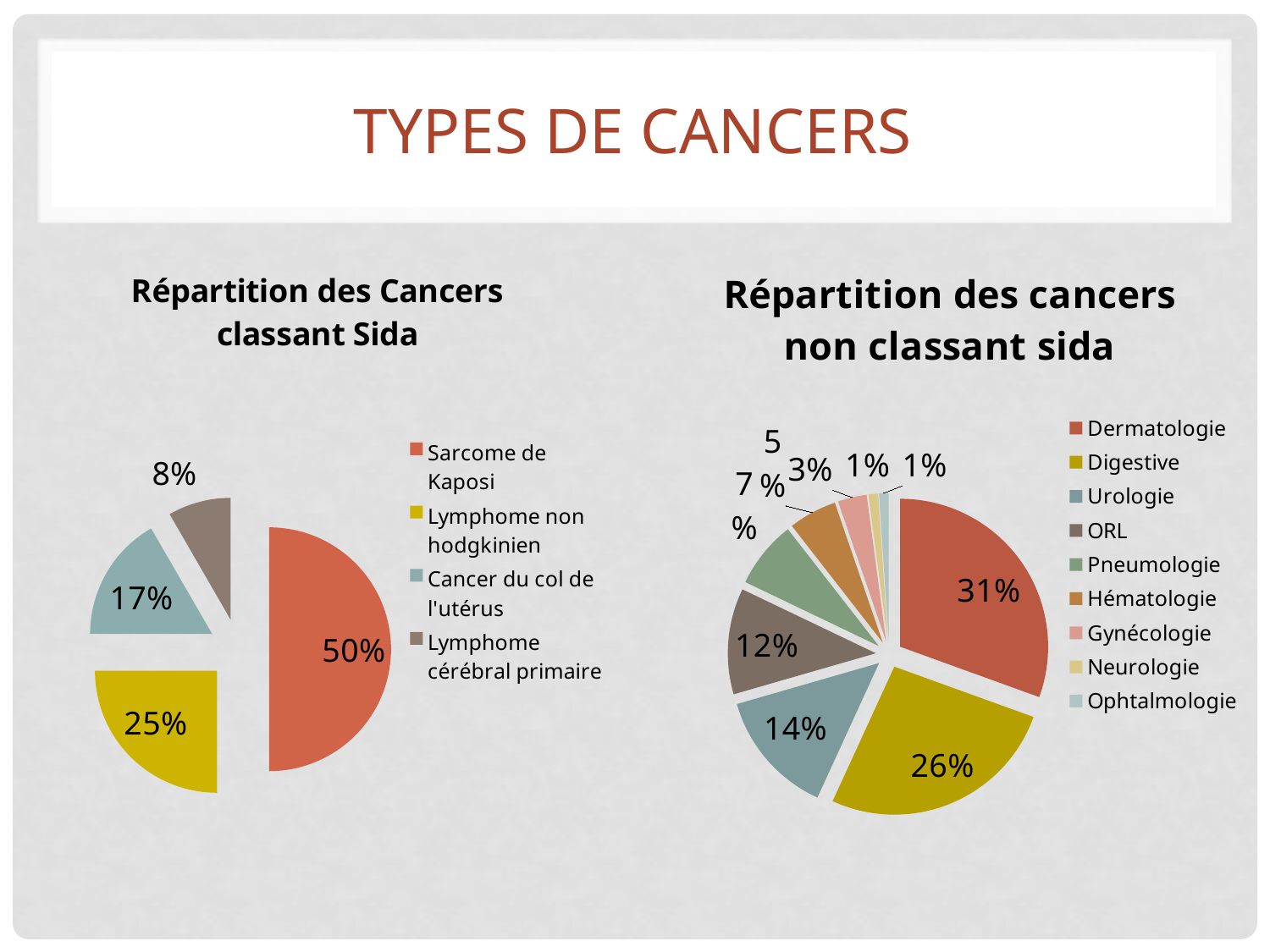
In the "Répartition des Cancers classant Sida" chart, what is the difference between the shares of Sarcome de Kaposi and Lymphome non hodgkinien? 25% In the "Répartition des cancers non classant sida" chart, what is the difference between the shares of Digestive and Urologie? 12% In the "Répartition des cancers non classant sida" chart, what share does Dermatologie have? 31% In the "Répartition des cancers non classant sida" chart, what share does Urologie have? 14% How many categories does the legend of the "Répartition des cancers non classant sida" chart list? 9 What kind of chart is "Répartition des Cancers classant Sida"? Pie chart In the "Répartition des Cancers classant Sida" chart, which category has the smallest share? Lymphome cérébral primaire In the "Répartition des Cancers classant Sida" chart, what share does Cancer du col de l'utérus have? 17% How many categories does the legend of the "Répartition des Cancers classant Sida" chart list? 4 In the "Répartition des cancers non classant sida" chart, which is larger, Digestive or ORL? Digestive In the "Répartition des cancers non classant sida" chart, which category has the largest share? Dermatologie In the "Répartition des Cancers classant Sida" chart, what share does Sarcome de Kaposi have? 50%